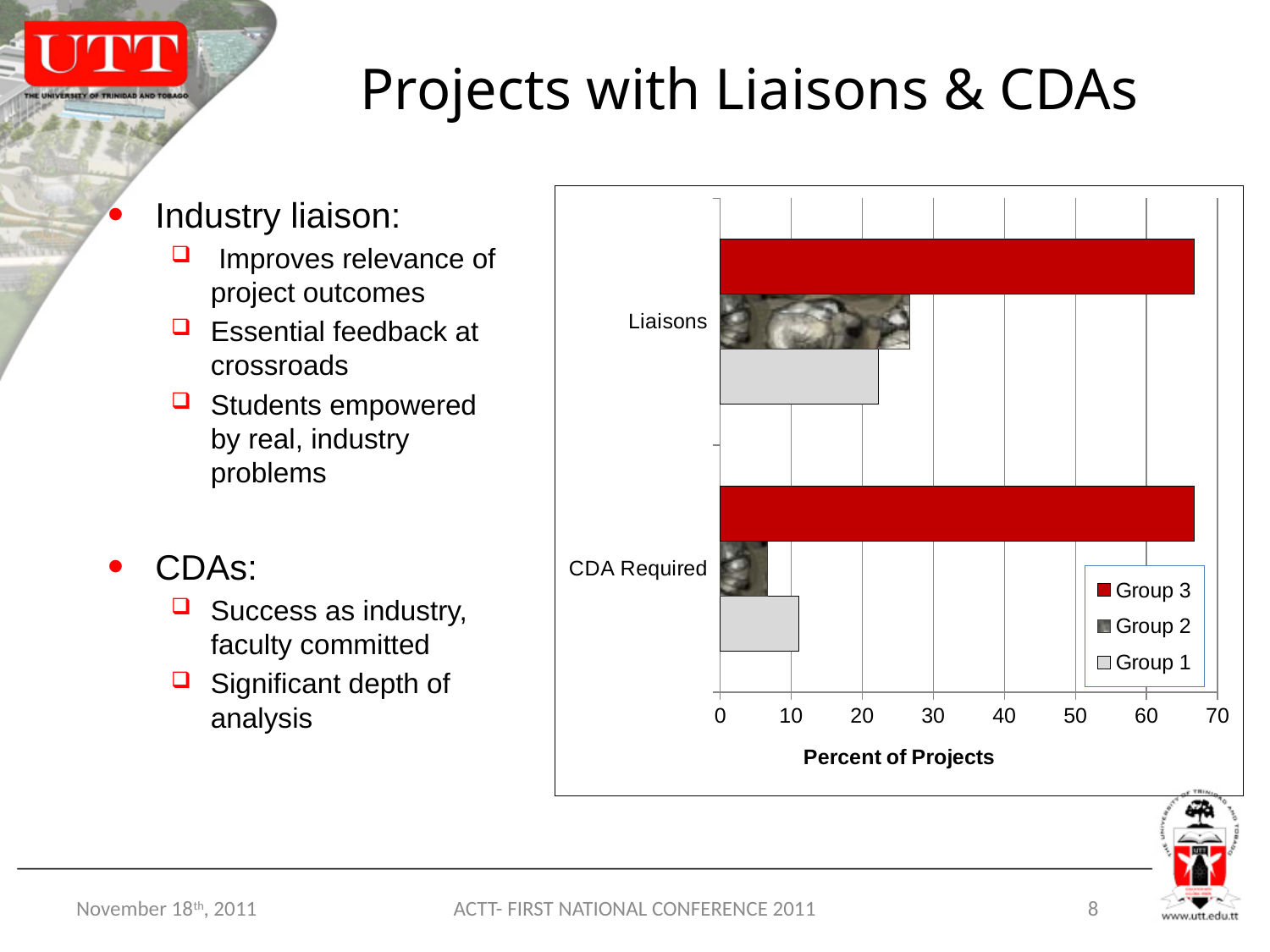
Which group has the lowest value in the CDA Required category? Group 2 Which group has the highest value in the Liaisons category? Group 3 How many categories are shown on the chart's vertical axis? 2 Which series is shown in red in the chart's legend? Group 3 What is the title of the chart's horizontal axis? Percent of Projects How many series does the chart's legend list? 3 Is the value for Group 1 in the Liaisons category greater or less than 30? less Is the value for Group 2 in the CDA Required category greater or less than 10? less Is the value for Group 3 in the CDA Required category greater or less than 60? greater What kind of chart is shown on the slide? bar chart In the CDA Required category, which is larger: the value for Group 1 or the value for Group 2? Group 1